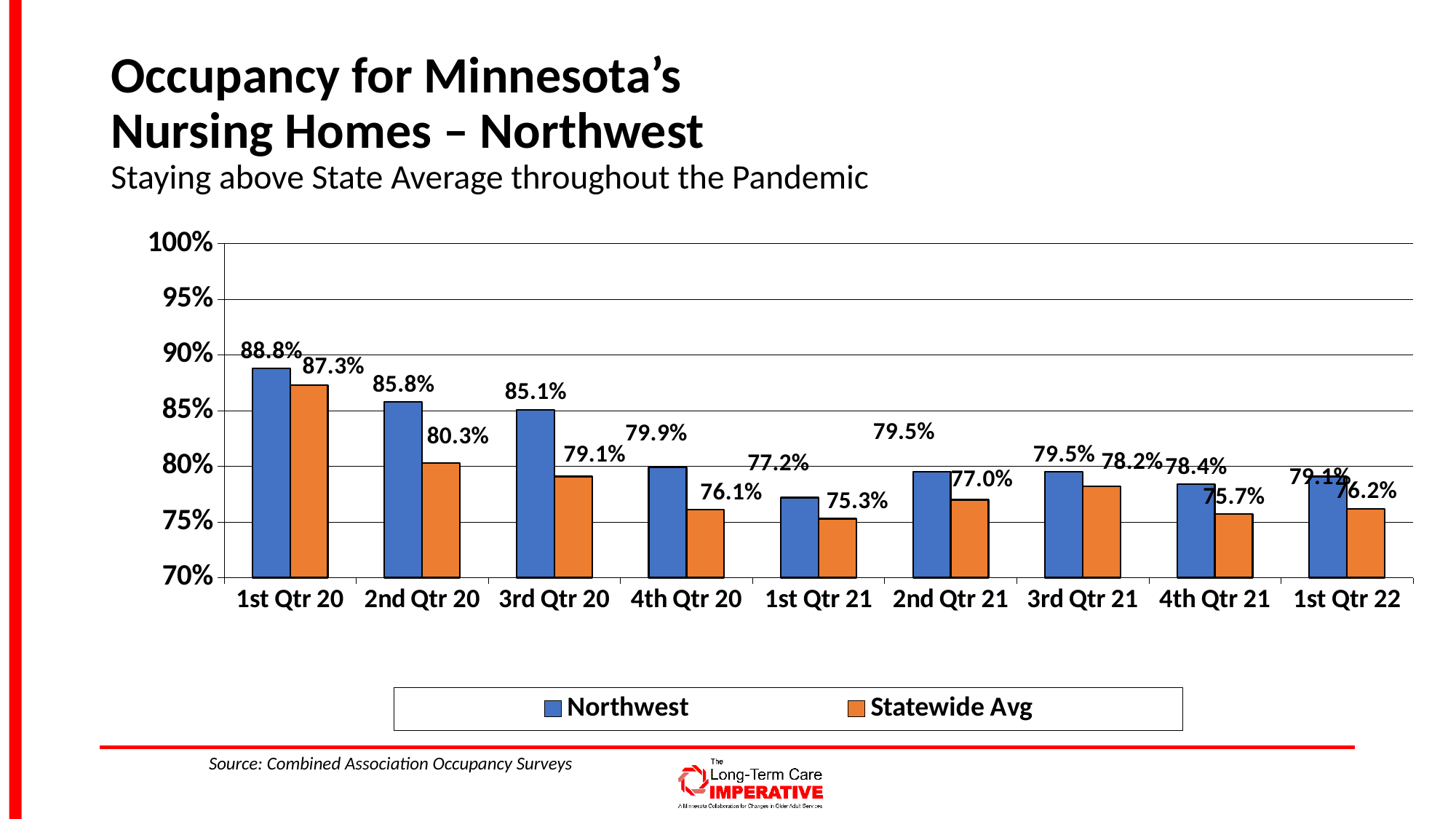
Is the Statewide Avg value for 4th Qtr 21 greater or less than 80%? less In which quarter is the Northwest occupancy highest? 1st Qtr 20 Does the Northwest occupancy rise or fall from 1st Qtr 20 to 1st Qtr 21? fall What is the difference between the Northwest and Statewide Avg values in 2nd Qtr 20? 5.5 percentage points What is the Statewide Avg value for 2nd Qtr 20? 80.3% How many quarters are shown on the x axis? 9 In 3rd Qtr 21, which is larger: Northwest or Statewide Avg? Northwest What is the Northwest value for 1st Qtr 21? 77.2% In which quarter is the Northwest occupancy lowest? 1st Qtr 21 What kind of chart is shown on the slide? bar chart What is the Northwest occupancy value for 1st Qtr 20? 88.8% How many series does the legend list? 2